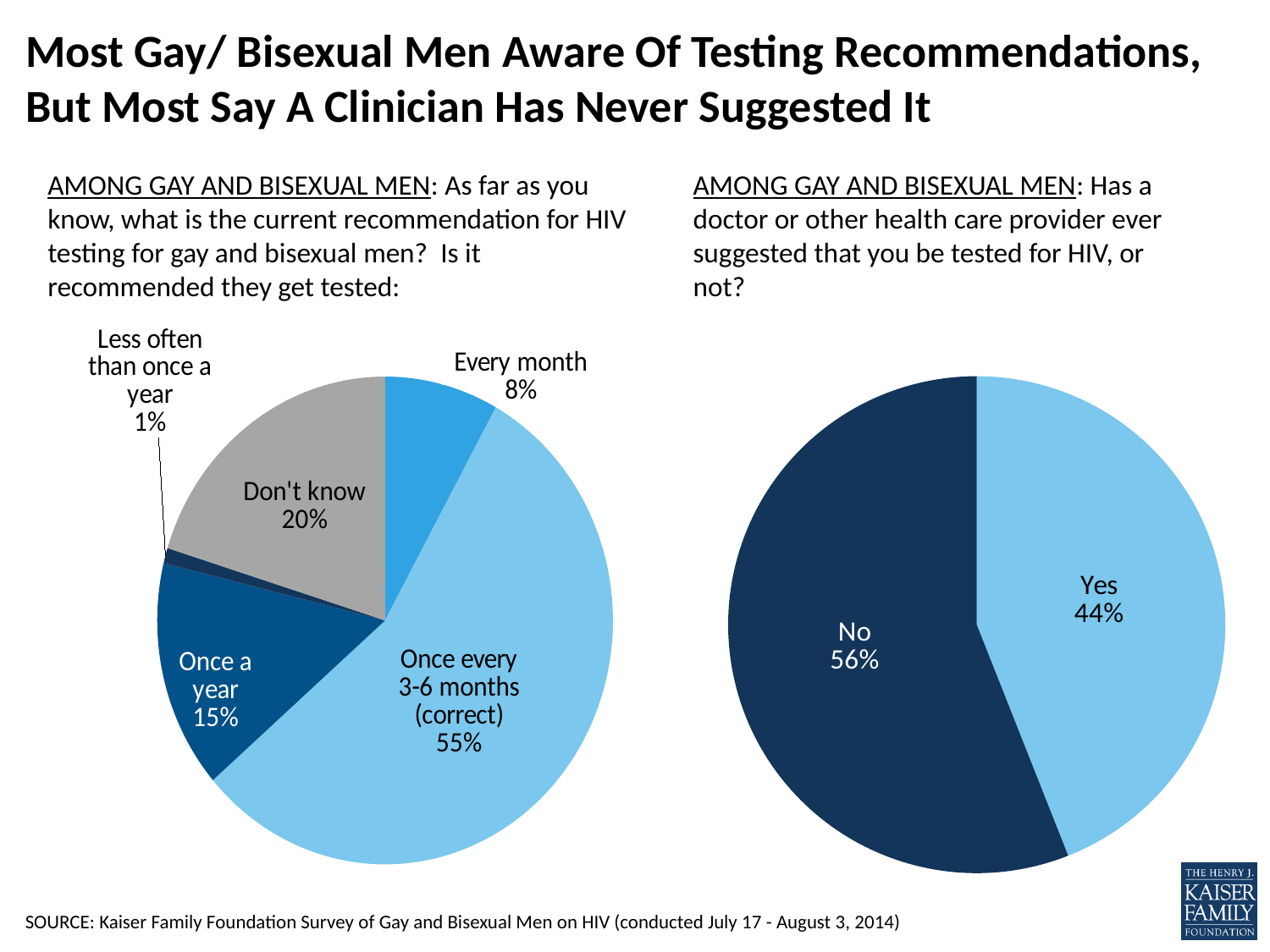
In the right pie chart, what percentage said a doctor or health care provider has suggested they be tested for HIV? 44% In the left pie chart, what share of gay and bisexual men said the recommendation is to get tested once every 3-6 months (correct)? 55% In the left pie chart, which response has the smallest share? Less often than once a year In the left pie chart, which is larger: 'Once a year' or 'Every month'? Once a year In the left pie chart, what is the difference in percentage points between 'Don't know' and 'Once a year'? 5 percentage points In the right pie chart, what is the difference in percentage points between 'No' and 'Yes'? 12 percentage points What type of chart is used on the right side of the slide? Pie chart In the right pie chart, what percentage answered 'No'? 56% In the left pie chart, what percentage said 'Every month'? 8% In the left pie chart, how many response categories are shown? 5 In the left pie chart, what percentage answered 'Don't know'? 20% In the left pie chart, which response has the largest share? Once every 3-6 months (correct)